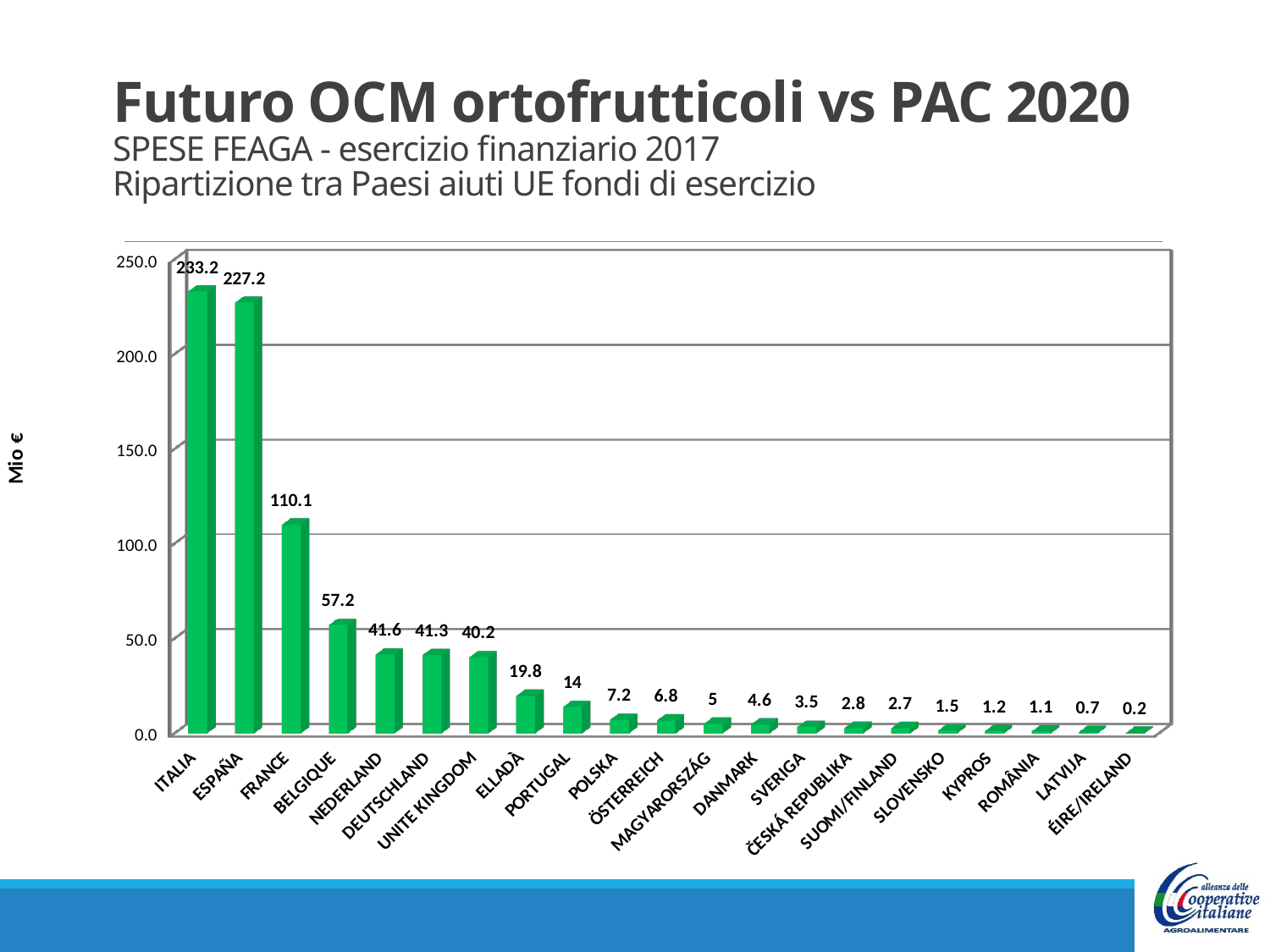
What is the difference between the values for FRANCE and BELGIQUE? 52.9 How many countries are shown on the x axis? 21 What is the difference between the values for ITALIA and ESPAÑA? 6 What is the label of the vertical axis? Mio € What is the value for ITALIA? 233.2 What kind of chart is shown on the slide? bar chart Which country has the highest value? ITALIA What is the value for PORTUGAL? 14 Is the value for BELGIQUE greater or less than 50.0? greater Which is larger, the value for ELLADA or the value for PORTUGAL? ELLADA Which country has the lowest value? ÉIRE/IRELAND What is the value for FRANCE? 110.1